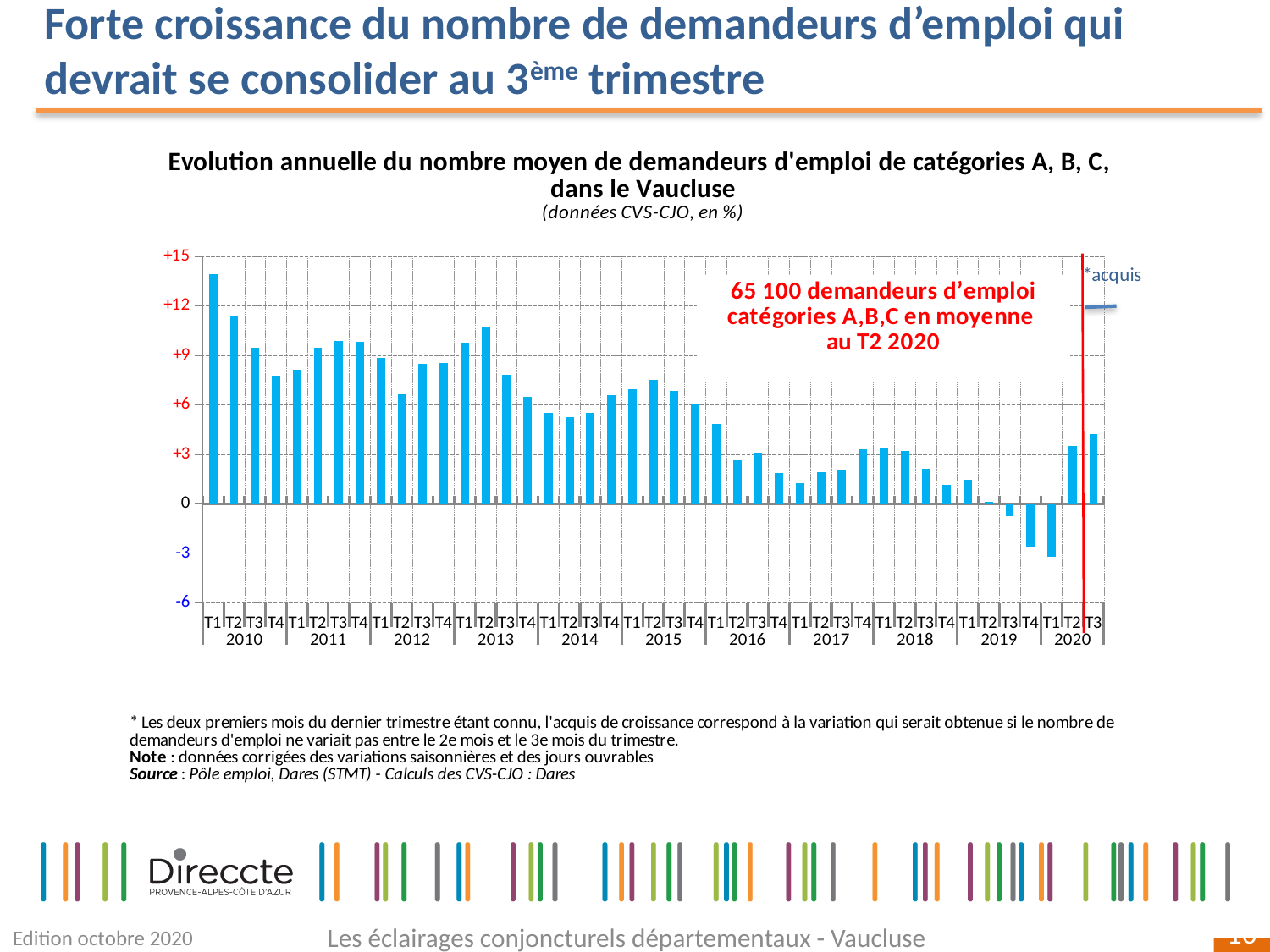
What is the title of the chart? Evolution annuelle du nombre moyen de demandeurs d'emploi de catégories A, B, C, dans le Vaucluse Which is larger, the value for T2 2010 or the value for T2 2015? T2 2010 Is the value for T2 2013 greater or less than +9? greater How many quarterly bars are plotted in the chart? 43 Is the value for T3 2020 greater or less than +3? greater What kind of chart is shown on the slide? bar chart Is the value for T4 2019 greater or less than 0? less Which quarter has the lowest value in the chart? T1 2020 Do the values generally rise or fall from 2010 to 2019? fall Which quarter has the highest value in the chart? T1 2010